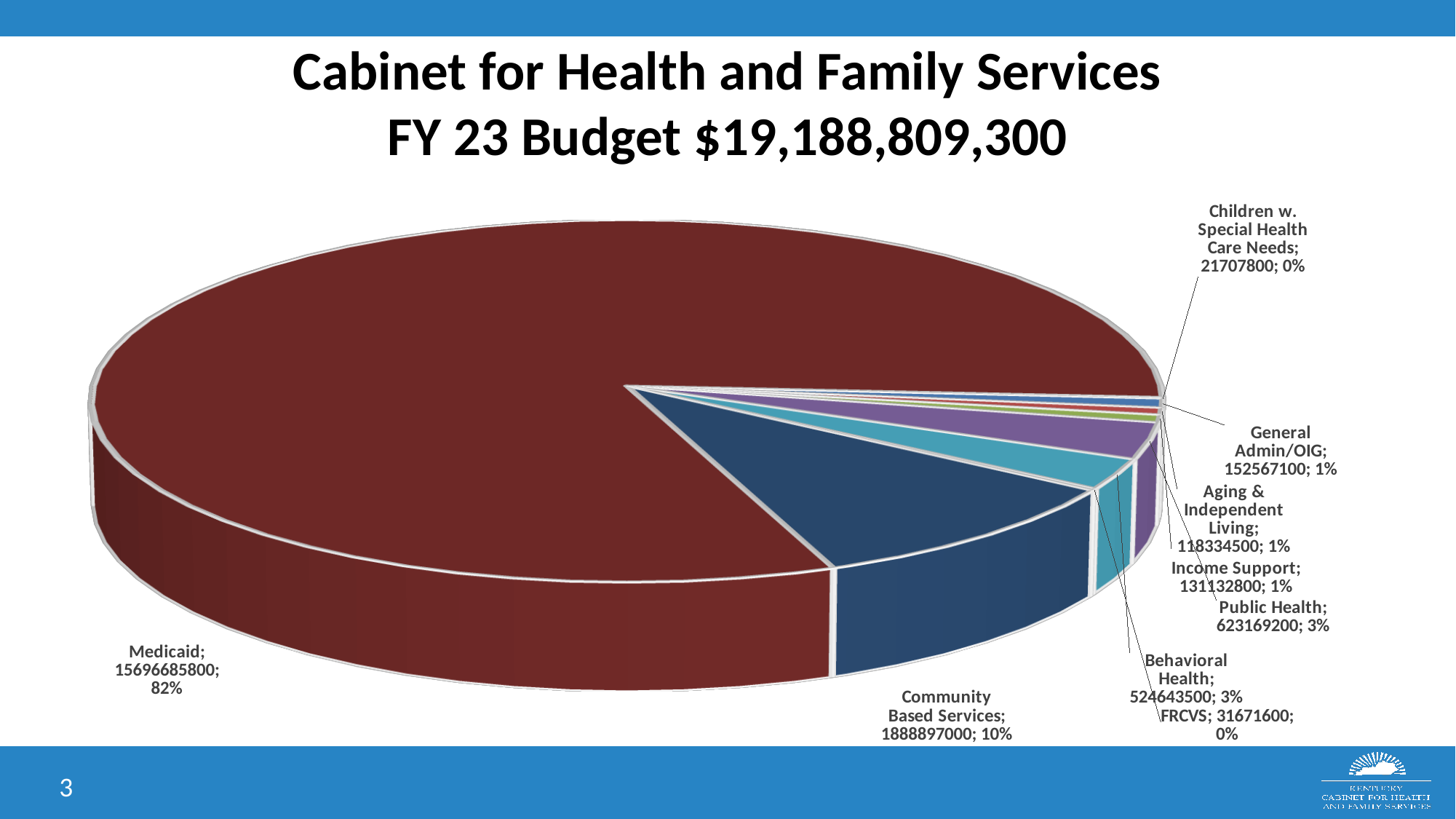
What is the difference between the values for Public Health and Behavioral Health? 98525700 What kind of chart is shown on the slide? Pie chart What total FY 23 budget is stated in the chart title? $19,188,809,300 Which is larger, the value for Income Support or the value for Aging & Independent Living? Income Support What is the value for Community Based Services? 1888897000 What share of the pie does Medicaid represent? 82% What share of the pie does Behavioral Health represent? 3% What is the value for Medicaid? 15696685800 What is the value for Public Health? 623169200 How many categories are shown in the pie chart? 9 Which category has the smallest value? Children w. Special Health Care Needs Which category has the largest value? Medicaid